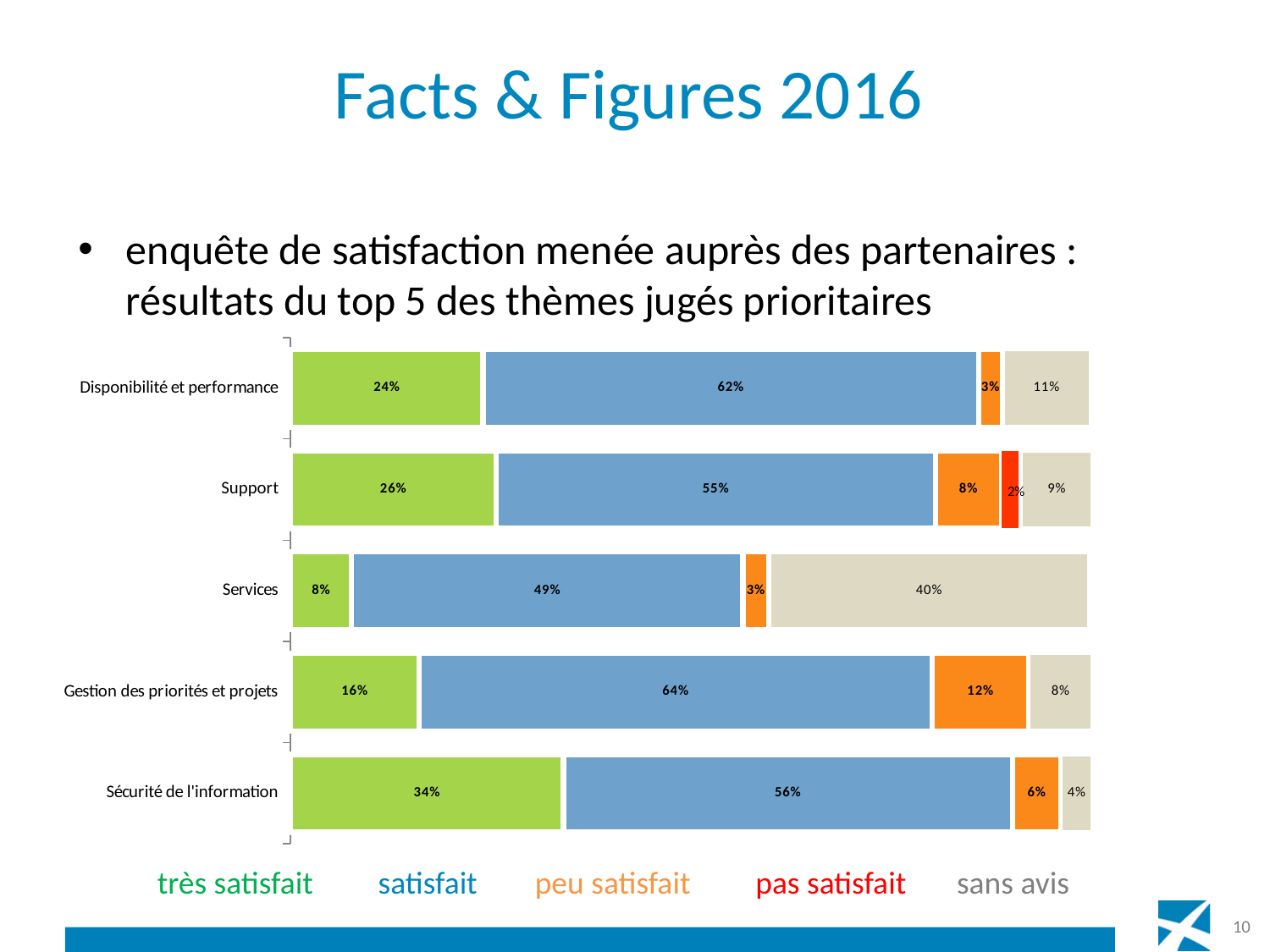
What is the difference between the 'satisfait' values for Disponibilité et performance and Support? 7% How many categories (themes) are shown in the chart? 5 Which category has the highest 'peu satisfait' value? Gestion des priorités et projets What is the 'pas satisfait' value for Support? 2% How many series does the legend list? 5 What is the 'sans avis' value for Services? 40% What is the 'très satisfait' value for Sécurité de l'information? 34% Which category has the lowest 'très satisfait' value? Services What is the 'satisfait' value for Gestion des priorités et projets? 64% Which category has the highest 'très satisfait' value? Sécurité de l'information Which is larger: the 'sans avis' value for Disponibilité et performance or for Support? Disponibilité et performance What kind of chart is shown on the slide? stacked bar chart